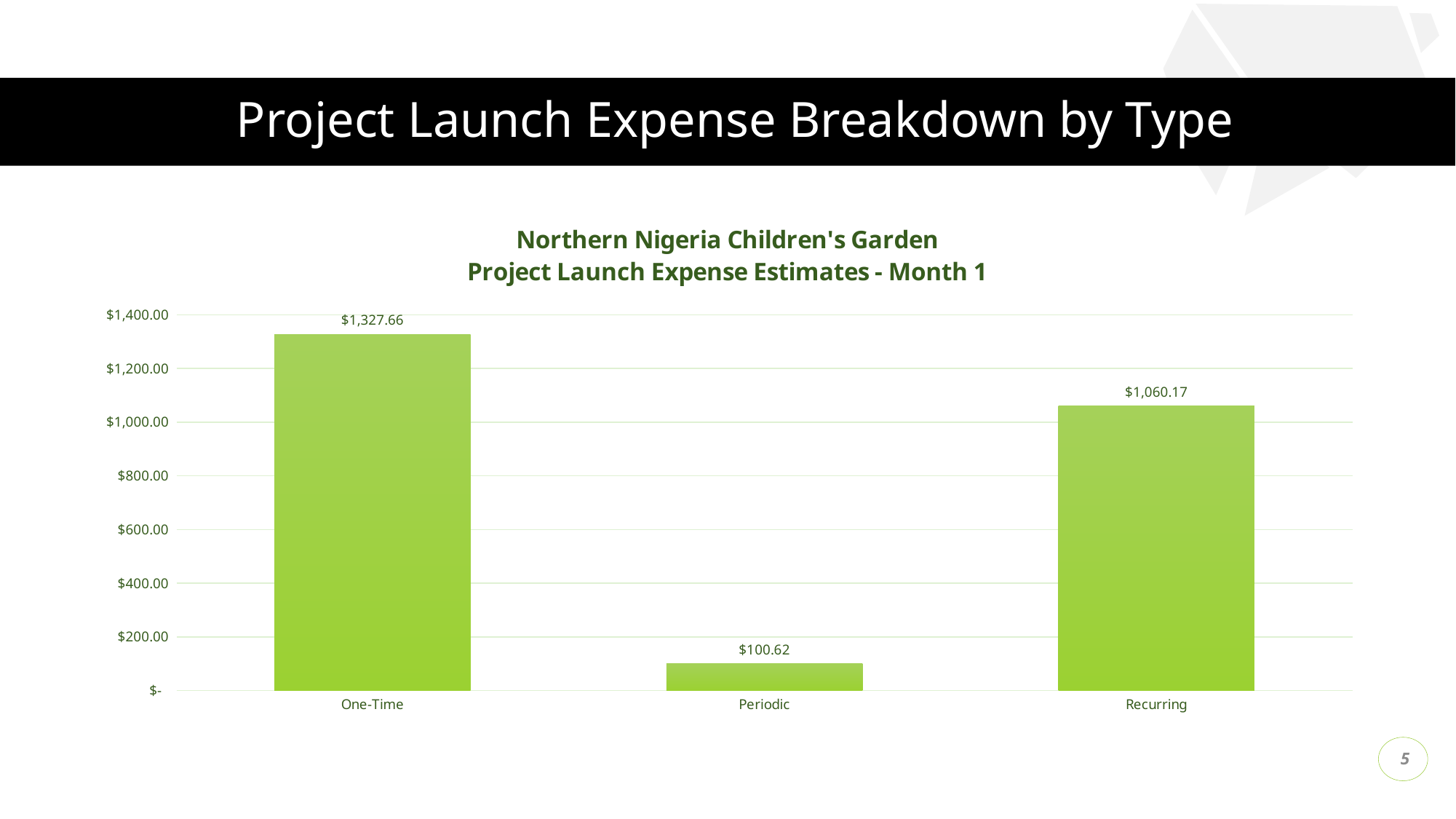
What is the expense estimate for One-Time? $1,327.66 Which expense type has the highest estimate? One-Time Is the value for Recurring greater or less than $1,000.00? greater How many expense types are shown in the chart? 3 What is the title of the chart? Northern Nigeria Children's Garden Project Launch Expense Estimates - Month 1 What is the difference between the One-Time and Recurring estimates? $267.49 What kind of chart is shown on the slide? Bar chart What is the difference between the Recurring and Periodic estimates? $959.55 What is the expense estimate for Recurring? $1,060.17 Which is larger, the One-Time estimate or the Recurring estimate? One-Time What is the expense estimate for Periodic? $100.62 Which expense type has the lowest estimate? Periodic